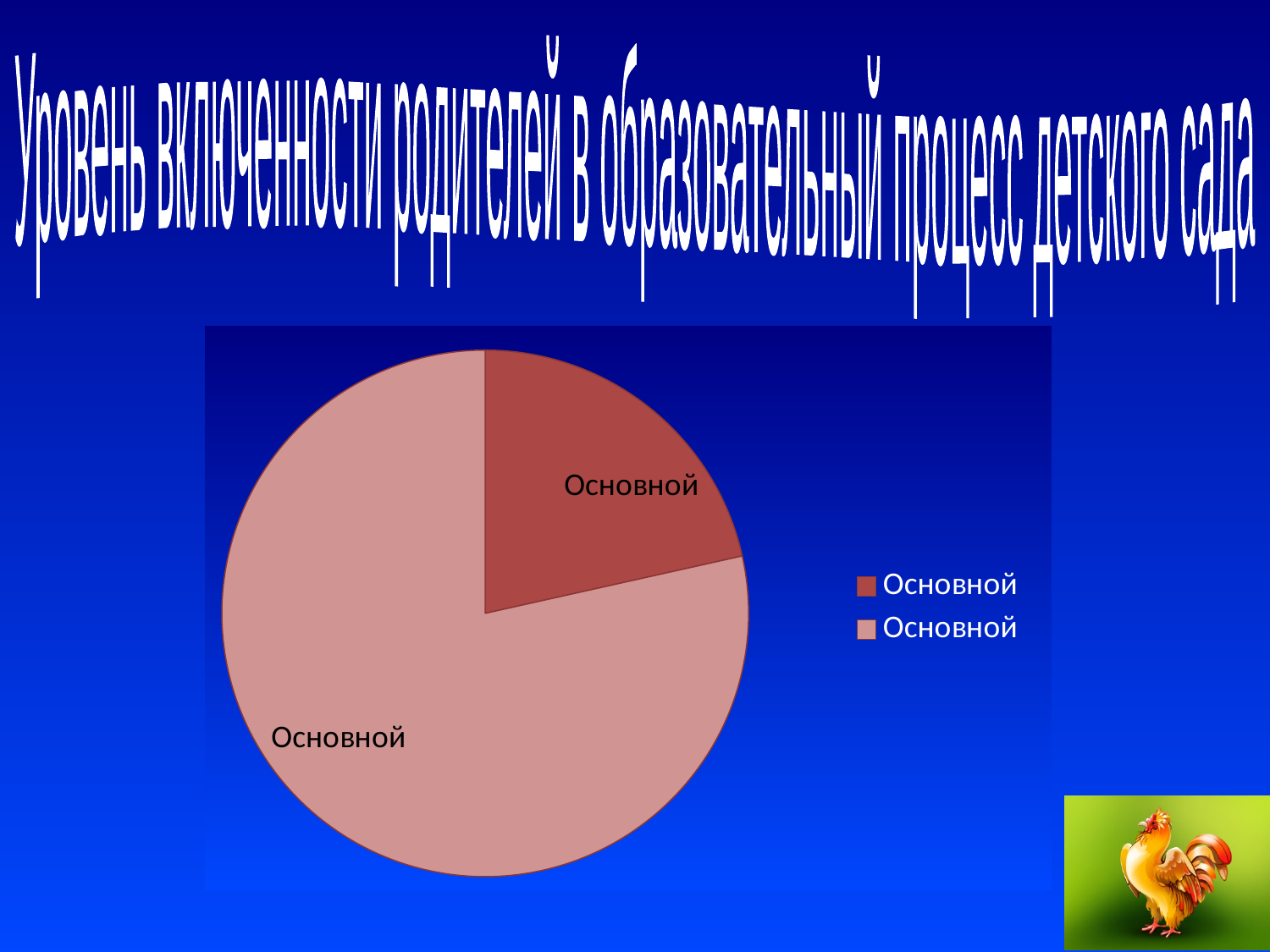
What is the title written at the top of the slide above the pie chart? Уровень включенности родителей в образовательный процесс детского сада Which slice of the pie chart is the largest, the dark red one or the light pink one? the light pink one How many entries does the legend of the pie chart list? 2 Is the light pink slice of the pie chart larger or smaller than the dark red slice? larger Which slice of the pie chart is the smallest, the dark red one or the light pink one? the dark red one What label is shown on each slice of the pie chart? Основной How many slices does the pie chart have? 2 What kind of chart is shown on the slide? pie chart